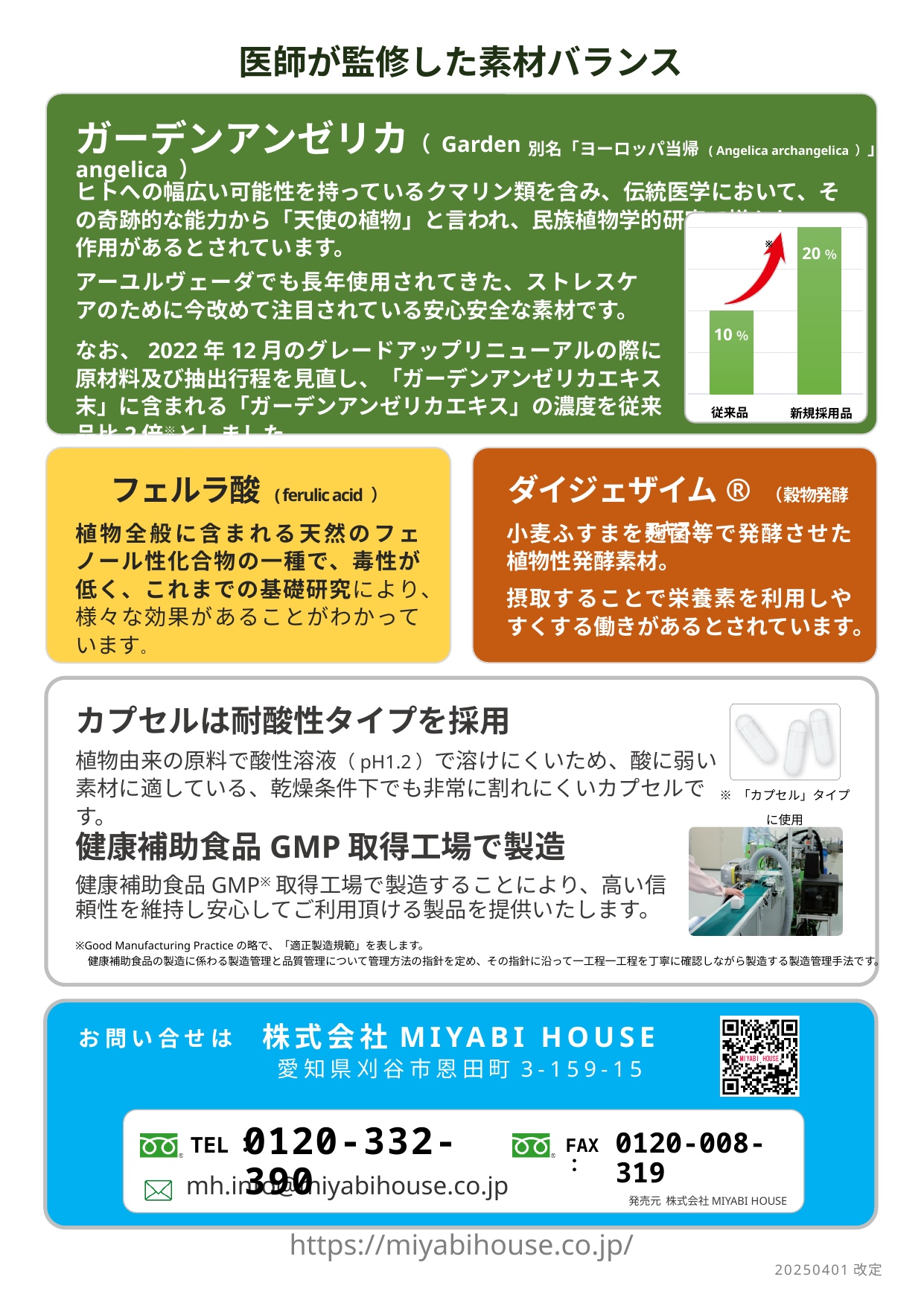
What kind of chart is shown on the slide? bar chart What is the value for 新規採用品 in the bar chart? 20% What is the difference between the values for 新規採用品 and 従来品 in the bar chart? 10% Which category has the highest value in the bar chart? 新規採用品 What is the label of the left bar in the bar chart? 従来品 What is the value for 従来品 in the bar chart? 10% How many categories are shown in the bar chart? 2 Which category has the lowest value in the bar chart? 従来品 Do the values in the bar chart rise or fall from 従来品 to 新規採用品? rise What colour are the bars in the bar chart? green Which is larger in the bar chart, the value for 従来品 or the value for 新規採用品? 新規採用品